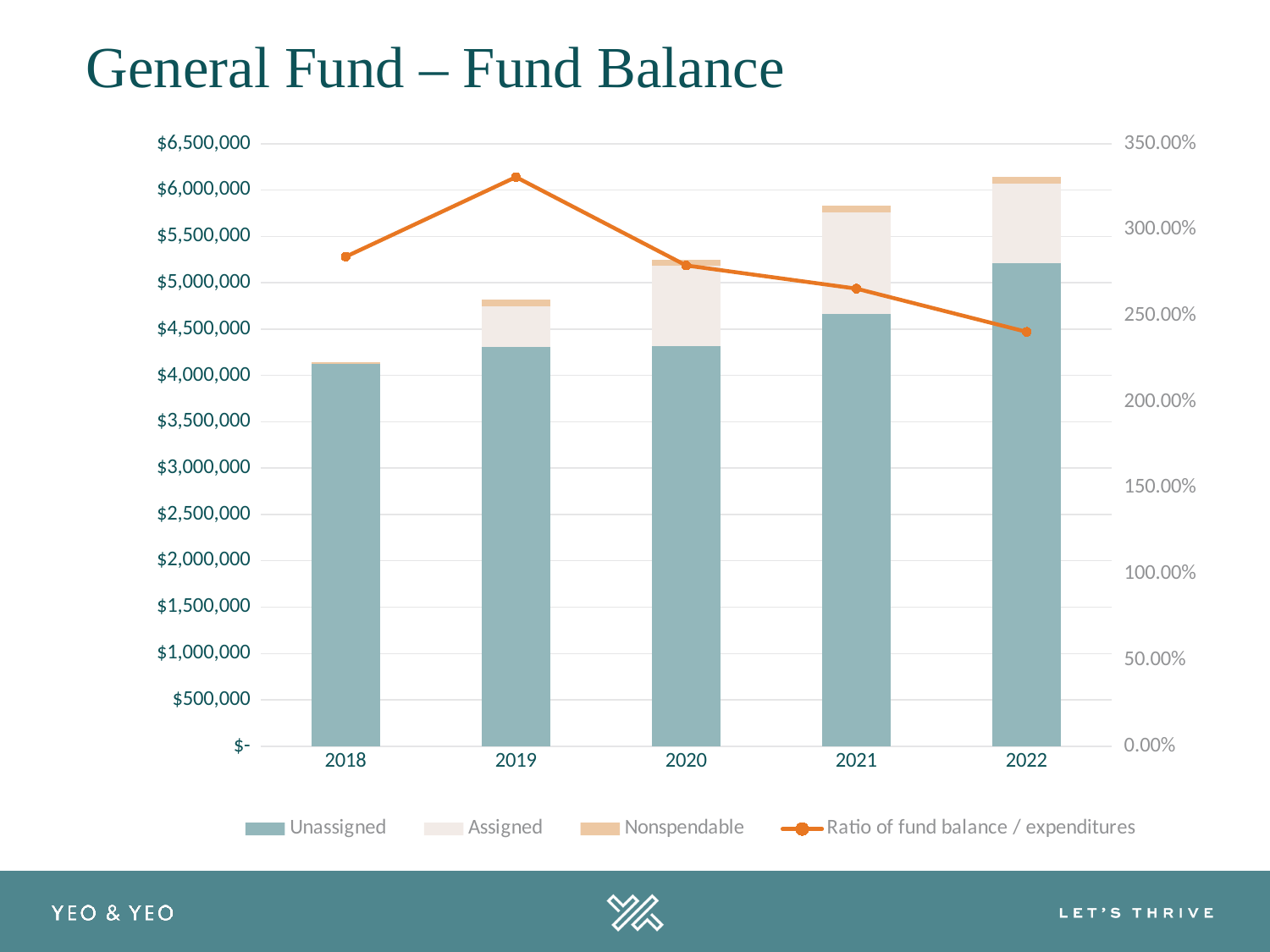
In which year is the ratio of fund balance / expenditures highest? 2019 In which year is the ratio of fund balance / expenditures lowest? 2022 Is the total stacked bar for 2018 greater or less than $4,500,000? less Which is larger, the Unassigned value for 2021 or for 2018? 2021 How many years are shown on the x axis? 5 Is the Unassigned value for 2022 greater or less than $5,000,000? greater Which year has the tallest stacked bar (largest total fund balance)? 2022 Does the ratio of fund balance / expenditures rise or fall from 2019 to 2022? fall What kind of chart is shown on the slide? A bar chart combined with a line How many series does the legend list? 4 Which year has the shortest stacked bar (smallest total fund balance)? 2018 Is the ratio of fund balance / expenditures for 2019 greater or less than 300.00%? greater